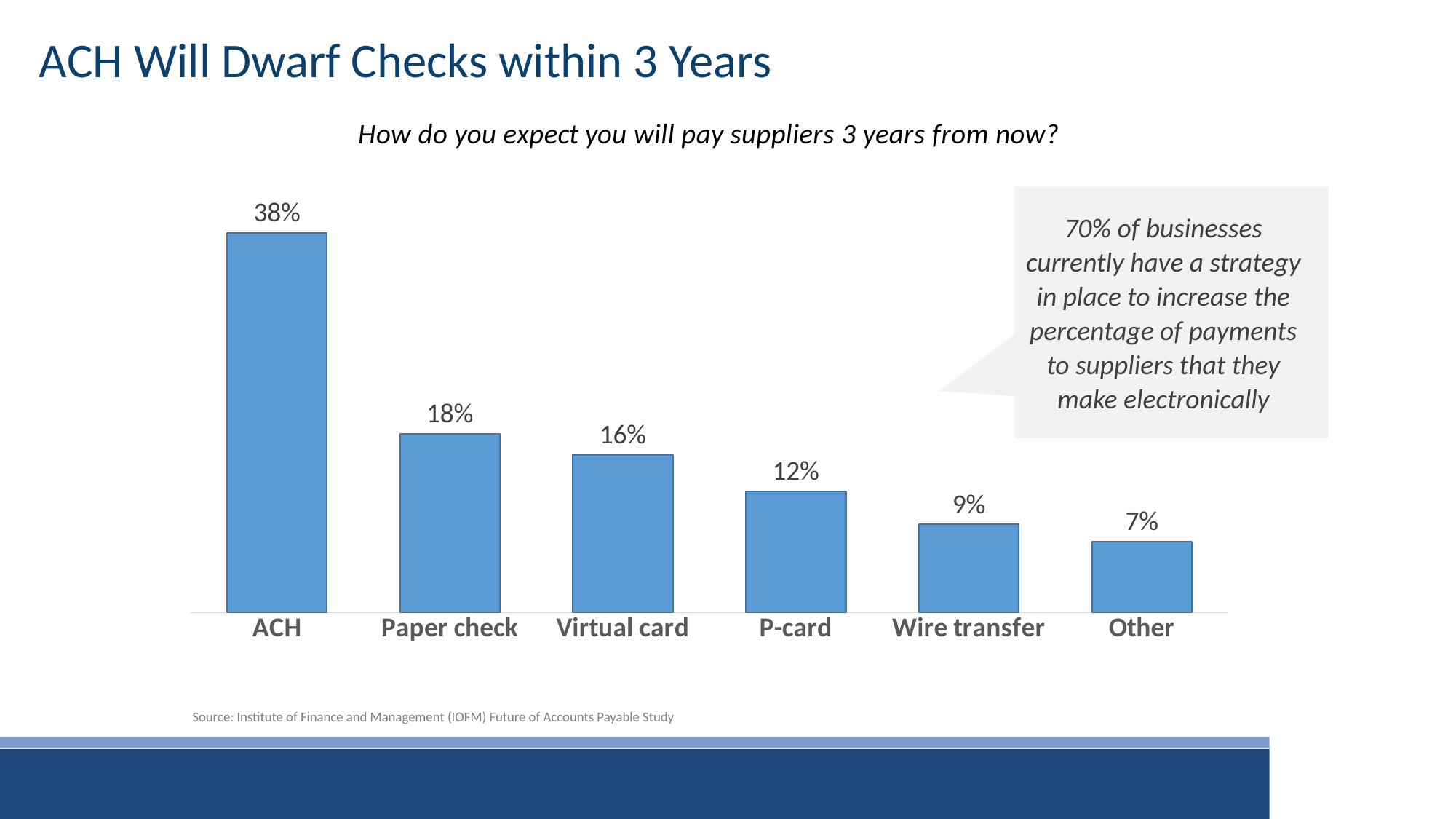
How many payment methods are shown on the chart? 6 What kind of chart is shown on the slide? Bar chart Which payment method has the highest expected share? ACH What percentage of respondents expect to pay suppliers by ACH 3 years from now? 38% Which is larger, the value for Virtual card or the value for P-card? Virtual card What is the value shown for Wire transfer? 9% What is the value shown for Virtual card? 16% Do the values rise or fall moving from left to right across the categories? Fall What is the difference between the ACH value and the Paper check value? 20% Which payment method has the lowest expected share? Other What is the value shown for Paper check? 18% What is the difference between the P-card value and the Other value? 5%